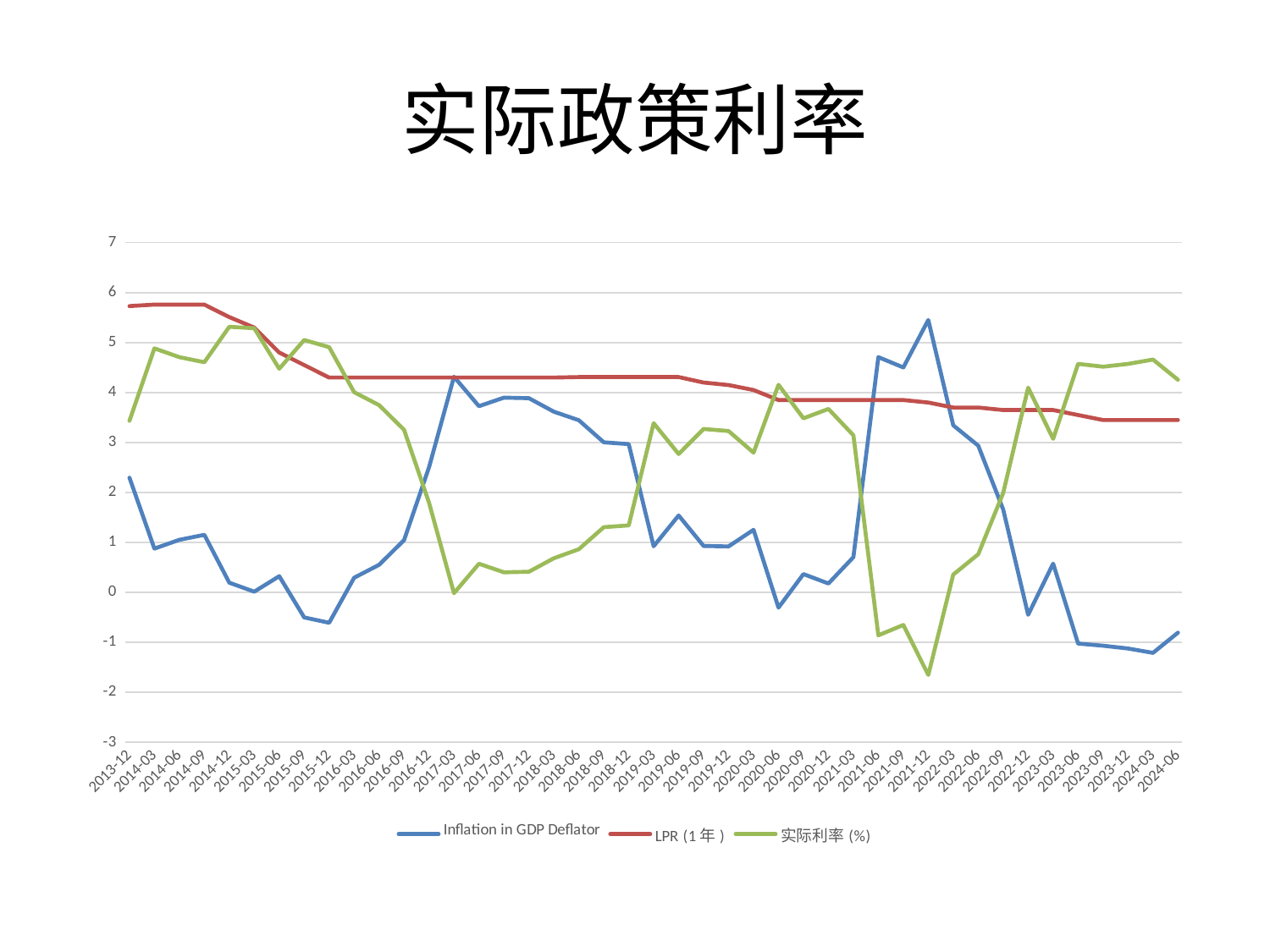
Is the value of 实际利率 (%) at 2021-12 greater or less than -1? less Is the value of LPR (1年) at 2024-06 greater or less than 4? less Is the value of LPR (1年) at 2013-12 greater or less than 5? greater Which series reaches the lowest value anywhere on the chart? 实际利率 (%) What is the title of the chart? 实际政策利率 At 2021-12, which is higher: Inflation in GDP Deflator or 实际利率 (%)? Inflation in GDP Deflator What kind of chart is shown on the slide? line chart How many series does the legend list? 3 Does the LPR (1年) series generally rise or fall from 2013-12 to 2024-06? fall Which series has the highest value at 2013-12? LPR (1年)